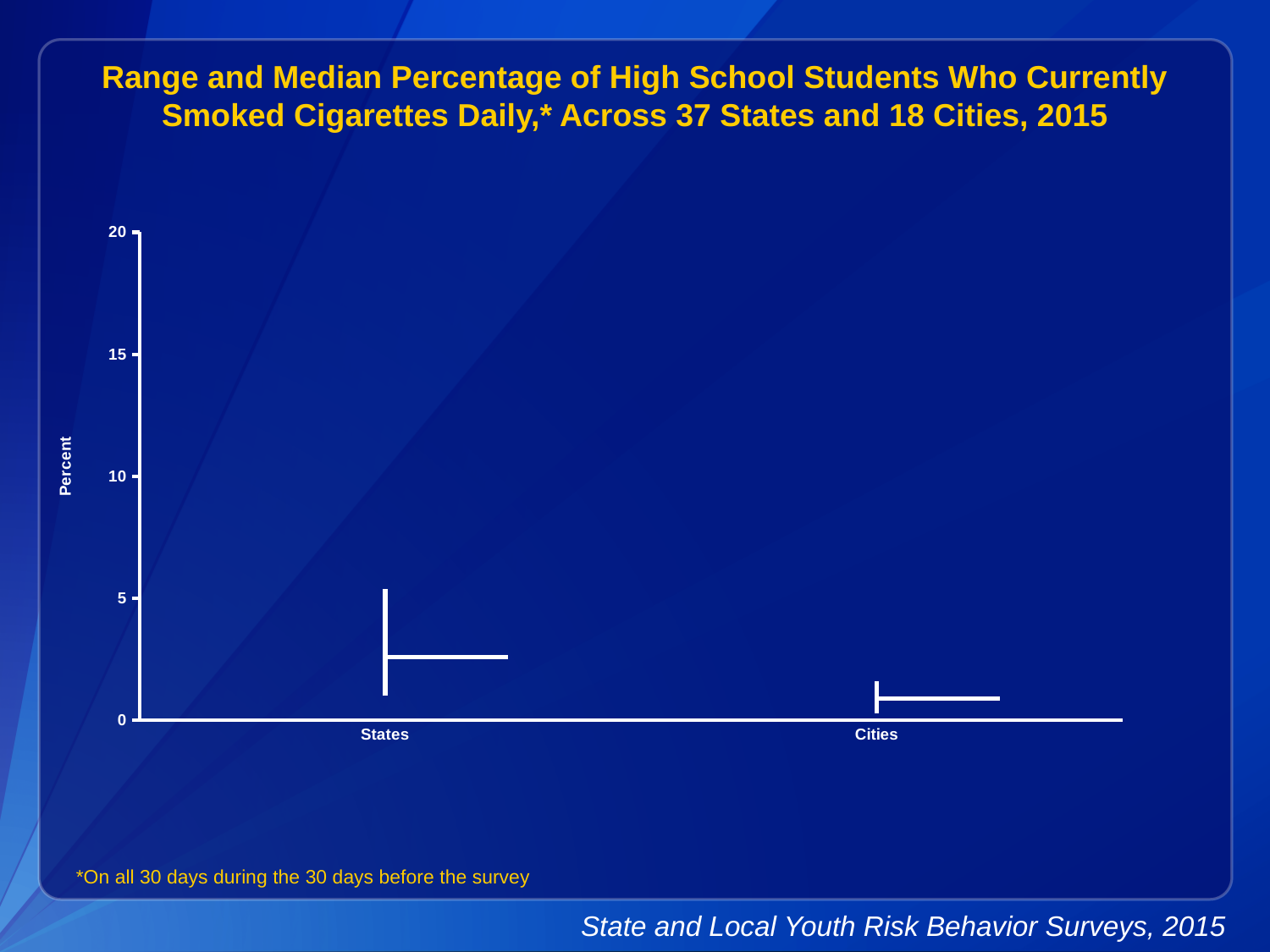
How many categories are shown on the x axis? 2 Is the top of the range for Cities greater or less than 5? less Which category shows the wider range of values? States Is the median value for States greater or less than 5? less Is the median value for Cities greater or less than 5? less Which category has the lower median value? Cities What are the two categories shown on the x axis? States and Cities What is the highest value shown on the y axis? 20 What is the title of the chart? Range and Median Percentage of High School Students Who Currently Smoked Cigarettes Daily,* Across 37 States and 18 Cities, 2015 Which category has the higher median value, States or Cities? States